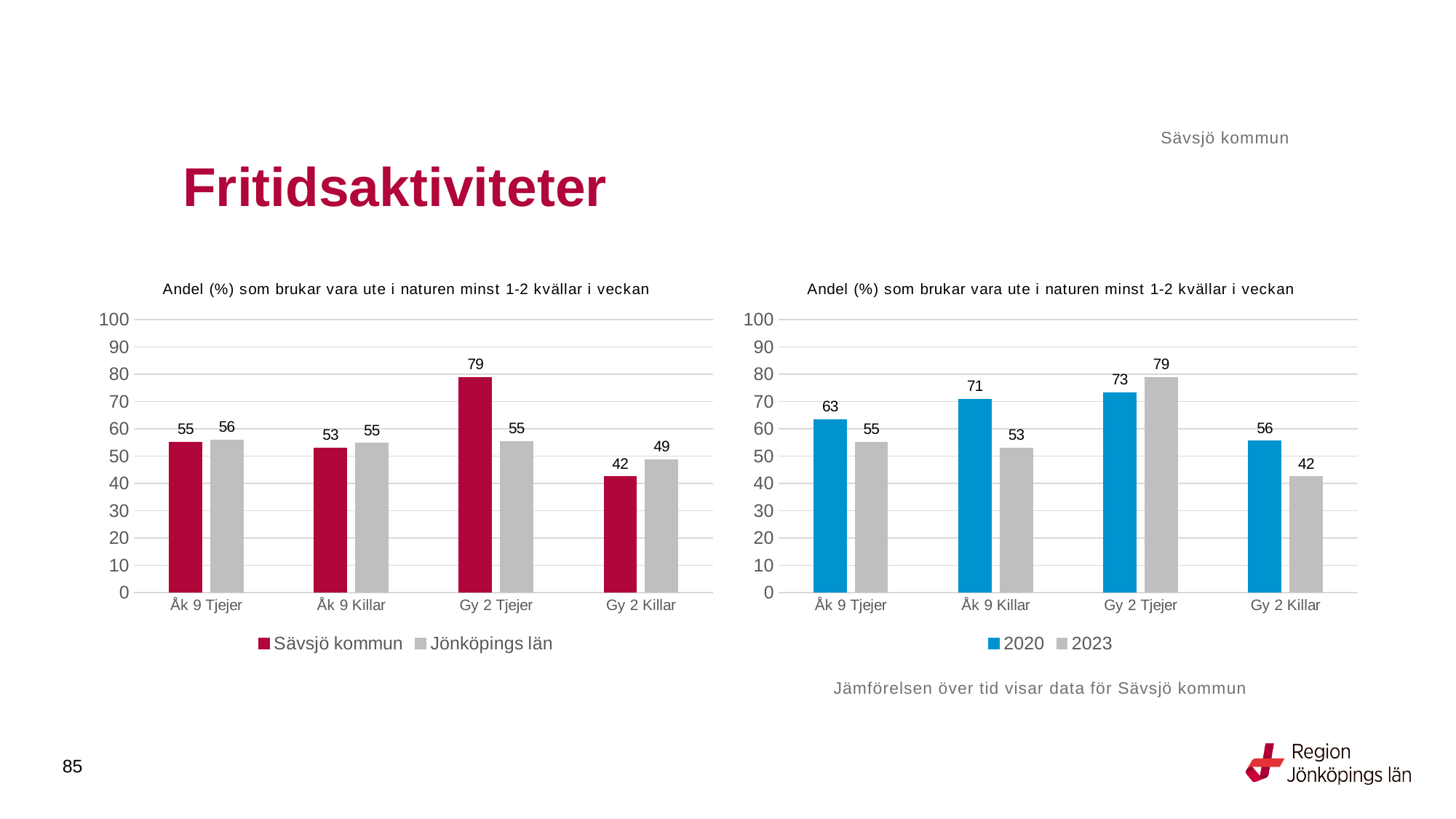
In the left chart, which category has the lowest value for Sävsjö kommun? Gy 2 Killar How many categories are shown on the x axis of the left chart? 4 In the left chart, what is the difference between Sävsjö kommun and Jönköpings län for Gy 2 Tjejer? 24 In the left chart, what is the value for Sävsjö kommun for Gy 2 Tjejer? 79 In the left chart, what is the value for Jönköpings län for Gy 2 Killar? 49 In the right chart, what is the difference between the 2020 and 2023 values for Åk 9 Killar? 18 In the right chart, which is larger for Gy 2 Tjejer: the 2020 value or the 2023 value? 2023 In the right chart, which category has the highest 2020 value? Gy 2 Tjejer In the right chart, what is the 2023 value for Åk 9 Tjejer? 55 What type of chart is the left chart? Bar chart How many series does the legend of the right chart list? 2 In the right chart, what is the 2020 value for Åk 9 Killar? 71